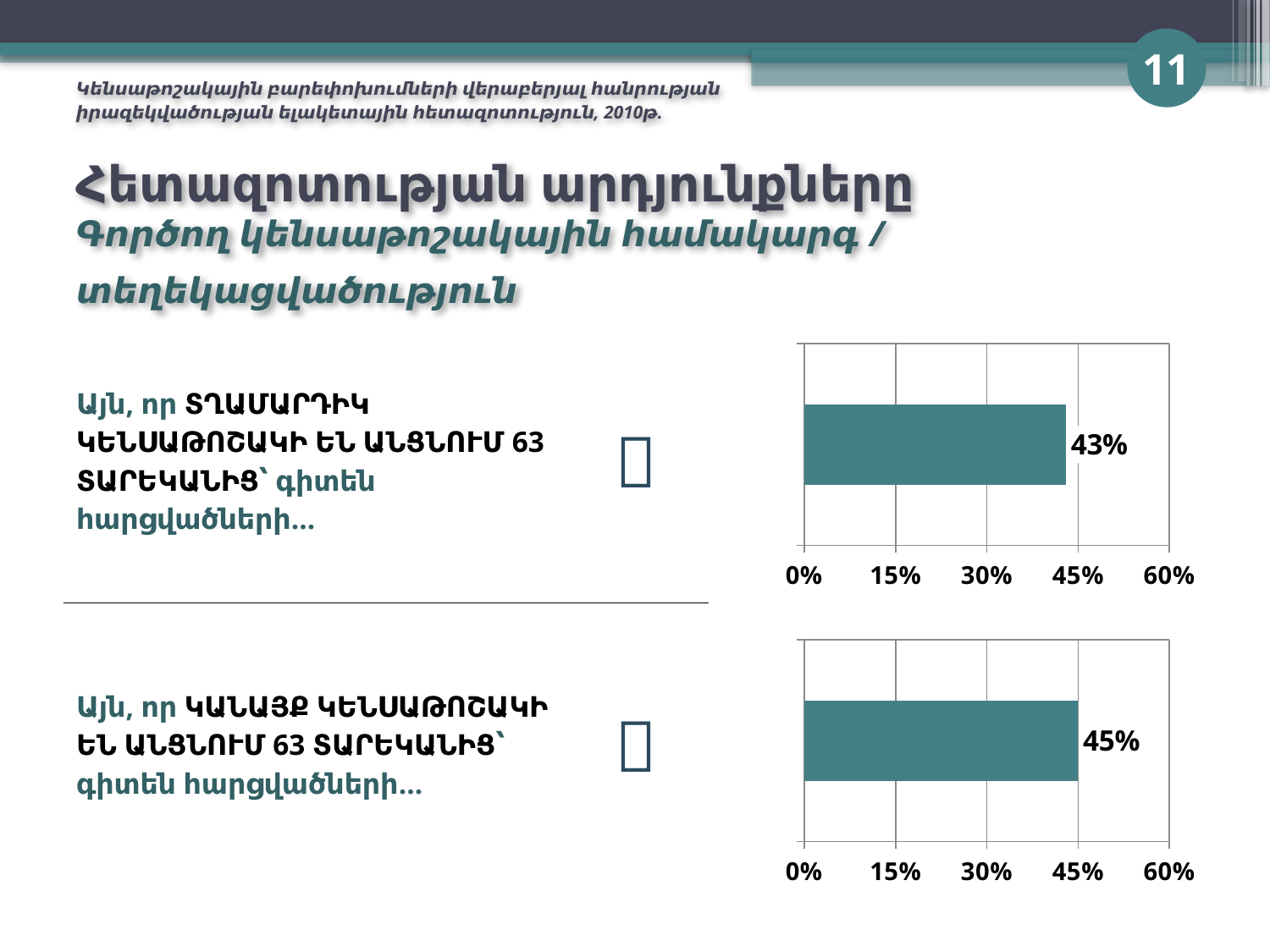
What kind of chart is the bottom chart on the slide? bar chart How many bars are plotted in the top chart? 1 In the top chart, is the bar's value greater or less than 30%? greater What value is shown by the bar in the top chart on the right side of the slide? 43% Which chart shows the larger value, the top chart or the bottom chart? the bottom chart What is the interval between the tick labels on the x axis of the top chart? 15% What kind of chart is the top chart on the slide? bar chart In the top chart, is the bar's value greater or less than 45%? less What value is shown by the bar in the bottom chart on the right side of the slide? 45% What is the maximum value shown on the x axis of the bottom chart? 60% What is the difference between the value in the bottom chart and the value in the top chart? 2% In the bottom chart, is the bar's value greater or less than 60%? less